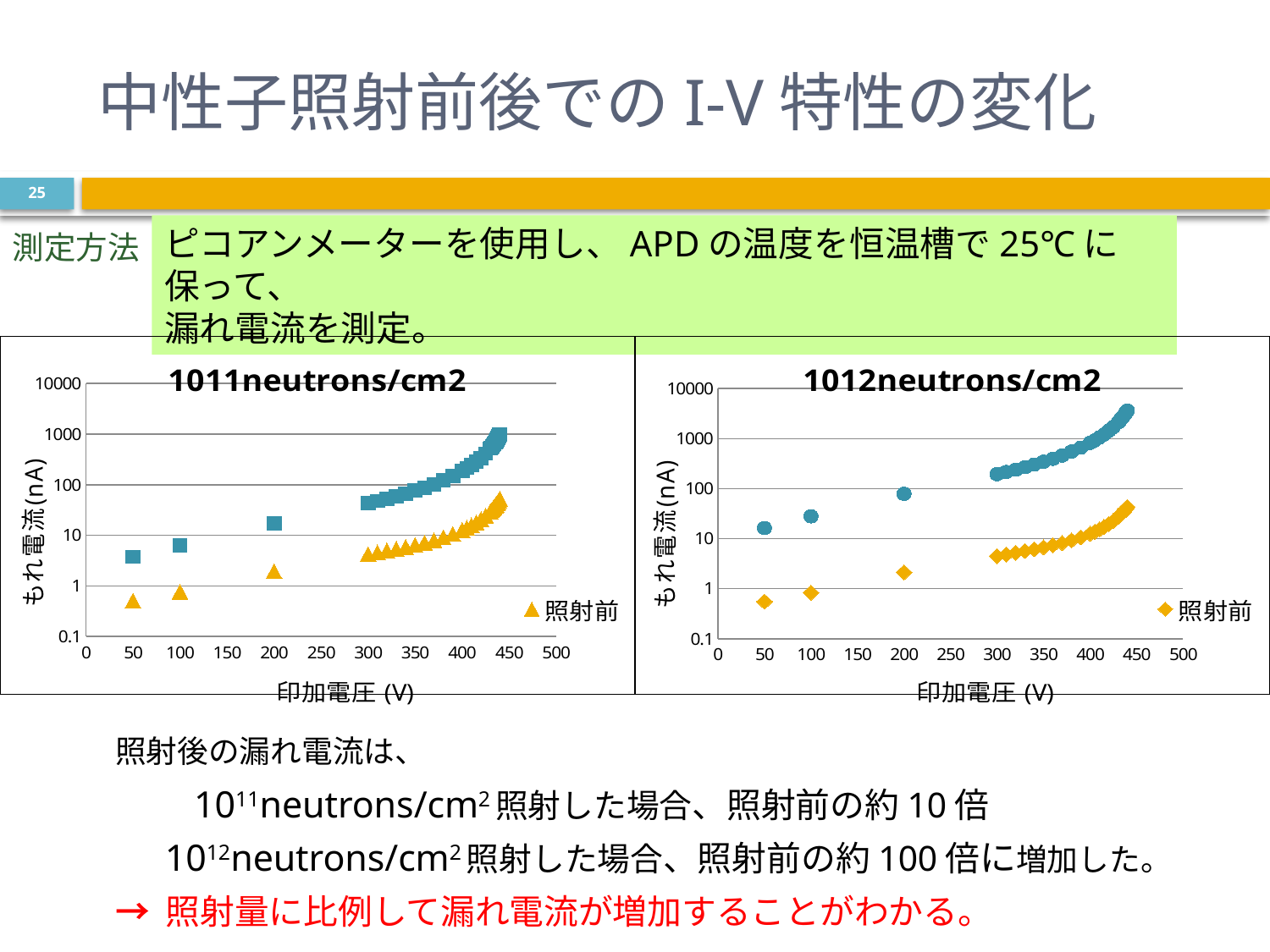
How many series does the legend of the 1012neutrons/cm2 chart list? 1 In the 1011neutrons/cm2 chart, is the 照射前 value at 50 V greater or less than 1? less In the 1012neutrons/cm2 chart, is the blue circle value at 200 V greater or less than 10? greater What kind of chart is the left chart titled 1011neutrons/cm2? scatter chart In the 1012neutrons/cm2 chart, is the highest value of the blue circle series greater or less than 1000? greater In the 1012neutrons/cm2 chart, which series has the larger value at 50 V, the blue circles or the 照射前 diamonds? blue circles What is the title of the right chart? 1012neutrons/cm2 In the 1011neutrons/cm2 chart, do the 照射前 values rise or fall as the applied voltage increases? rise What is the x-axis label of the 1011neutrons/cm2 chart? 印加電圧 (V)